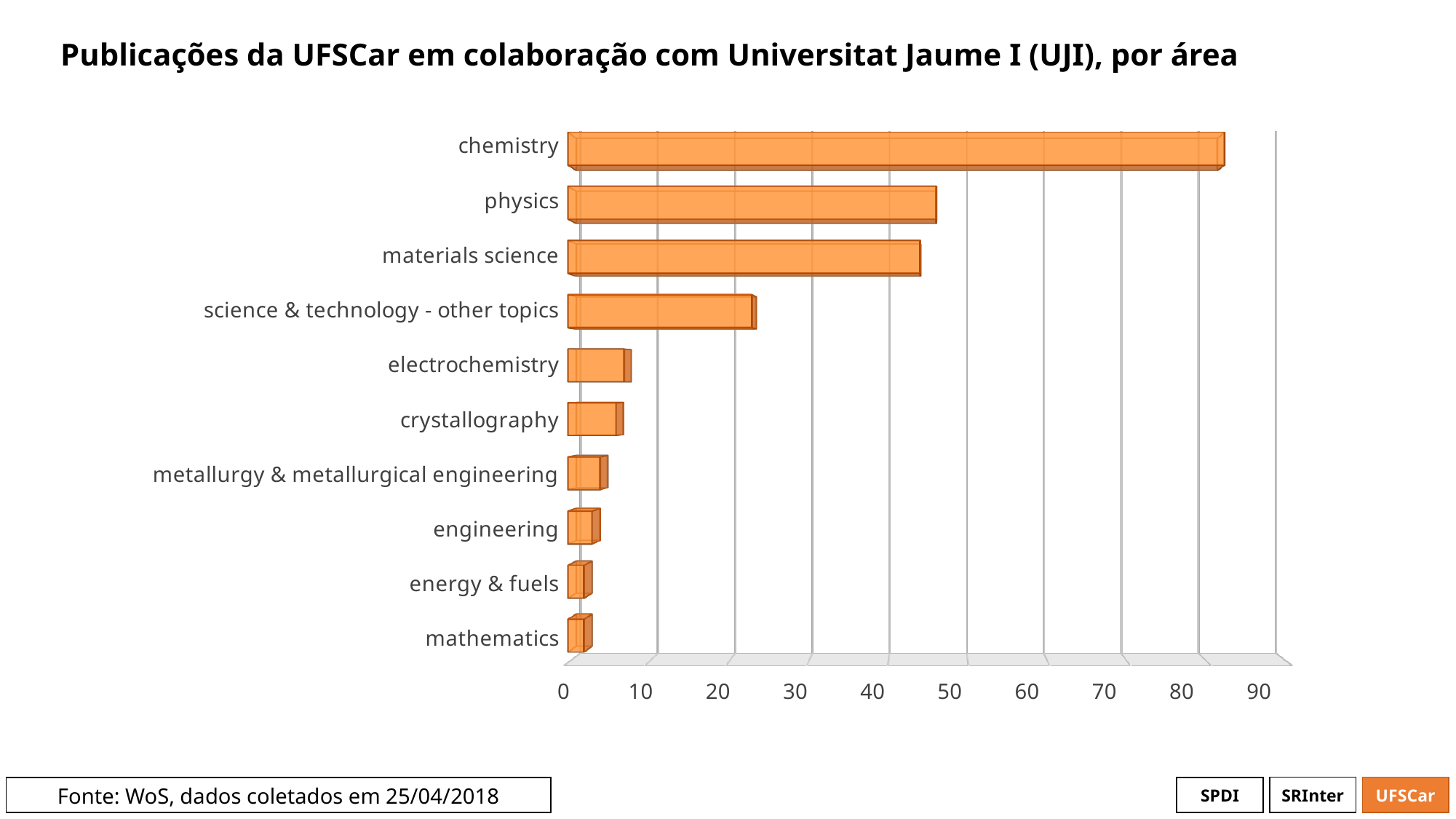
Is the value for chemistry greater or less than 80? greater Is the value for electrochemistry greater or less than 10? less What kind of chart is shown on the slide? bar chart Is the value for materials science greater or less than 40? greater Which has more publications, science & technology - other topics or electrochemistry? science & technology - other topics Which area has the highest number of publications? chemistry Which has more publications, chemistry or physics? chemistry What is the title of the chart? Publicações da UFSCar em colaboração com Universitat Jaume I (UJI), por área How many areas (categories) are shown in the chart? 10 Which has more publications, materials science or crystallography? materials science